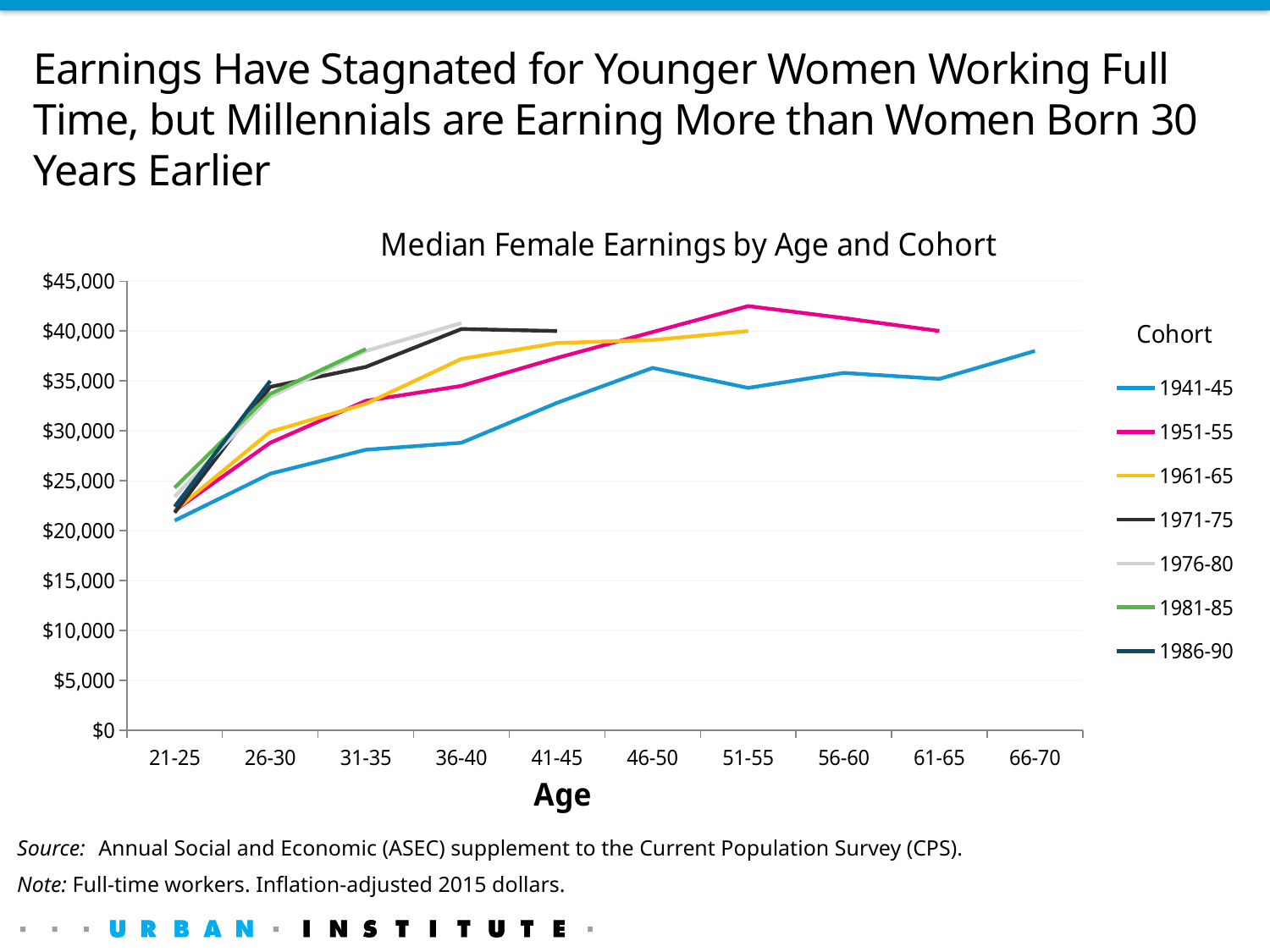
Is the median earnings value for the 1941-45 cohort at age 66-70 greater or less than $40,000? less What is the title of the chart? Median Female Earnings by Age and Cohort At age 26-30, which cohort has higher median earnings: 1986-90 or 1941-45? 1986-90 Is the median earnings value for the 1951-55 cohort at age 51-55 greater or less than $40,000? greater What kind of chart is shown on the slide? line chart How many cohorts does the legend list? 7 Do median earnings for the 1941-45 cohort rise or fall from age 21-25 to age 46-50? rise How many age groups are shown along the x axis? 10 Is the median earnings value for the 1961-65 cohort at age 36-40 greater or less than $35,000? greater Which cohort reaches the highest median earnings value anywhere on the chart? 1951-55 At age 36-40, which cohort has higher median earnings: 1971-75 or 1941-45? 1971-75